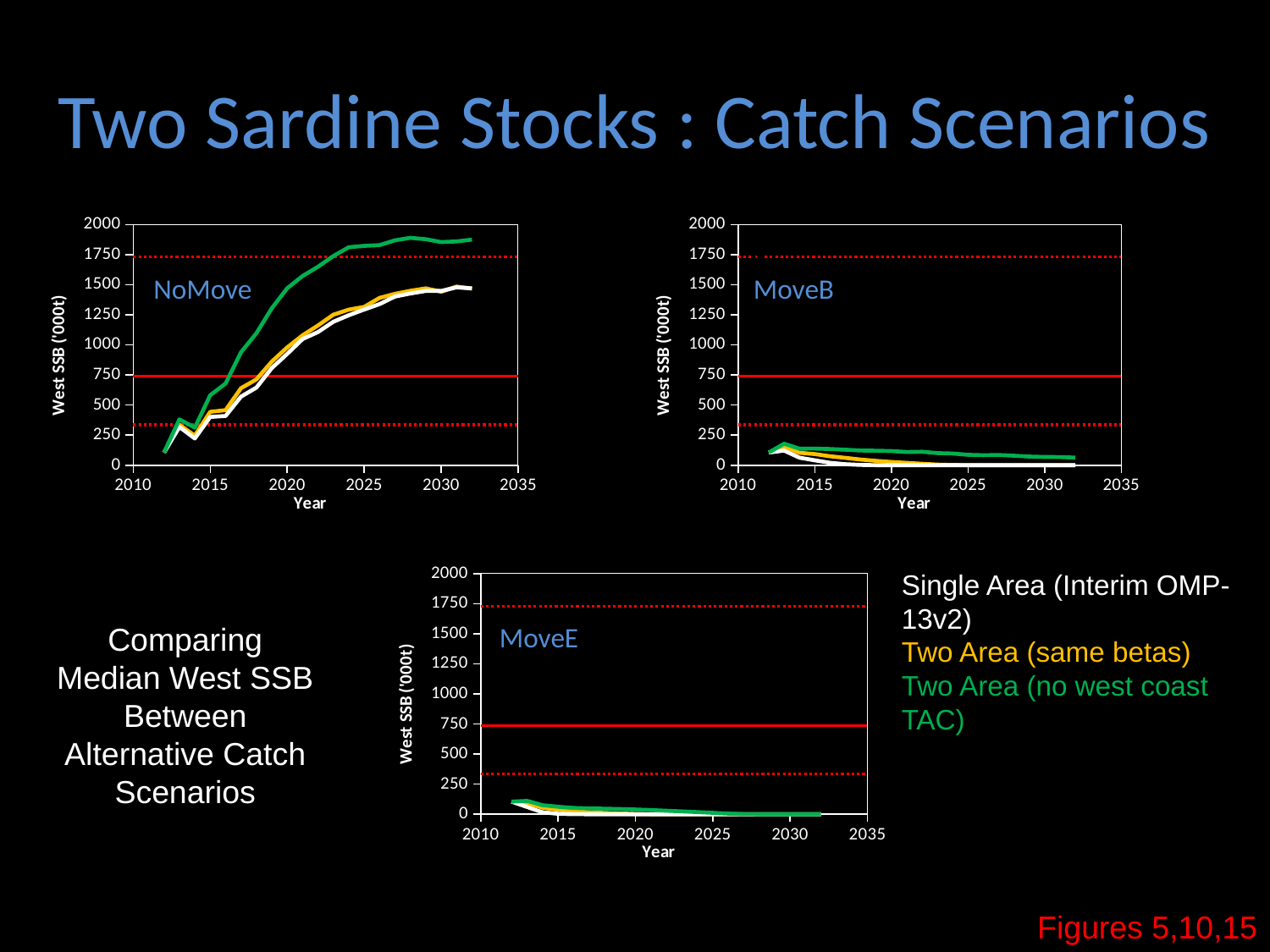
What kind of chart is the NoMove chart? line chart In the NoMove chart, is the green line's value at 2030 greater or less than 1750? greater How many catch scenarios does the legend on the right of the slide list? 3 In the NoMove chart, is the white line's value at 2030 greater or less than 1250? greater What is the y-axis label on the MoveE chart? West SSB ('000t) In the NoMove chart, is the green line's value at 2020 greater or less than 1000? greater In the NoMove chart, which line is higher at 2025, the green line or the yellow line? green line In the NoMove chart, does the green line rise or fall from 2012 to 2032? rise How many charts are shown on the slide? 3 In the MoveB chart, does the green line rise or fall from 2013 to 2032? fall